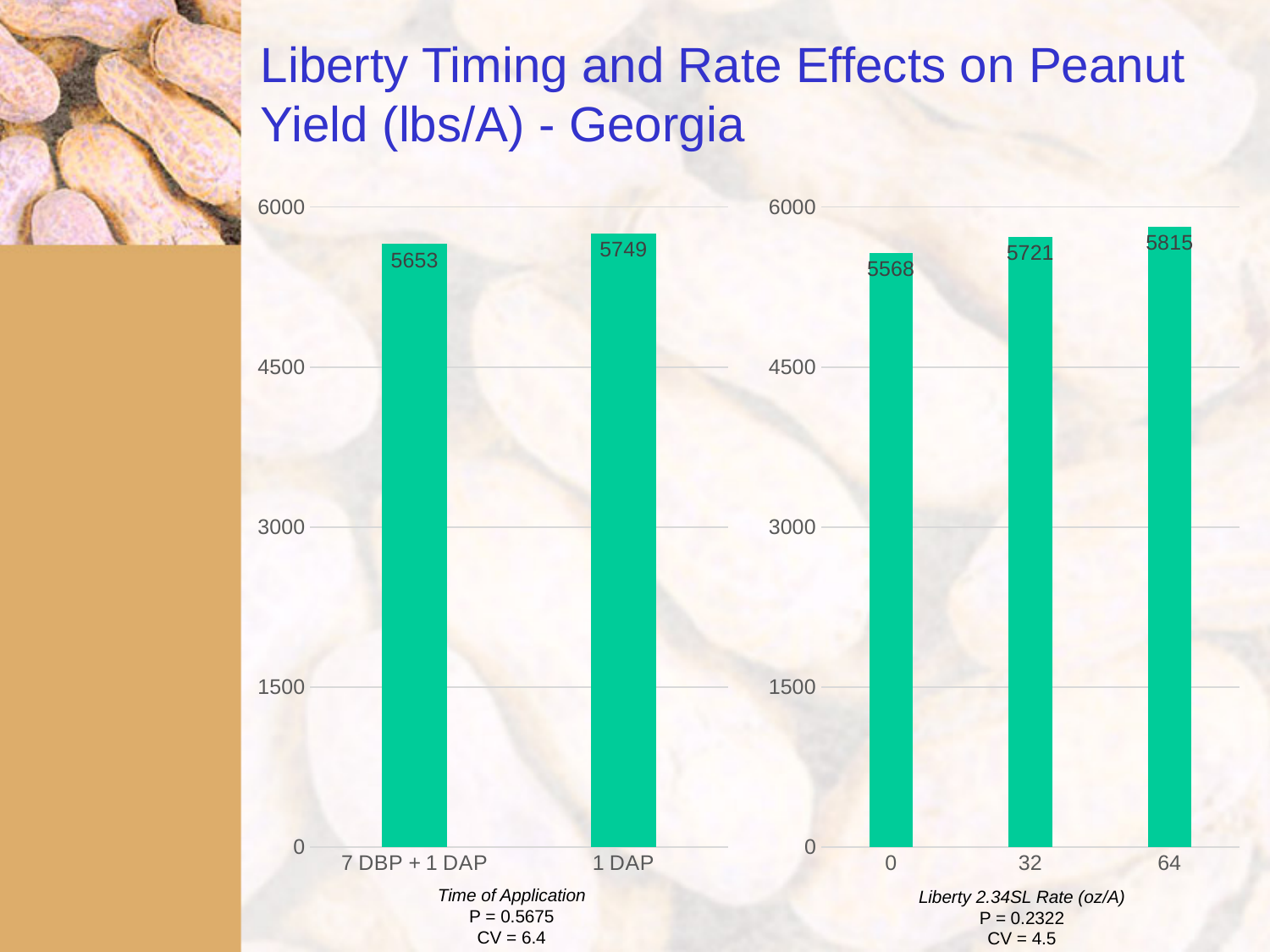
How many categories are shown in the right chart (Liberty 2.34SL Rate)? 3 In the right chart (Liberty 2.34SL Rate), do yields rise or fall as the rate increases from 0 to 64? Rise In the left chart (Time of Application), what is the yield for 7 DBP + 1 DAP? 5653 What type of chart is the left chart (Time of Application)? Bar chart In the right chart (Liberty 2.34SL Rate), what is the difference in yield between the 64 and 0 oz/A rates? 247 In the left chart (Time of Application), which has the larger yield, 7 DBP + 1 DAP or 1 DAP? 1 DAP In the right chart (Liberty 2.34SL Rate), which rate has the highest yield? 64 In the left chart (Time of Application), what is the difference in yield between 1 DAP and 7 DBP + 1 DAP? 96 In the right chart (Liberty 2.34SL Rate), what is the yield at the 0 oz/A rate? 5568 In the left chart (Time of Application), what is the yield for 1 DAP? 5749 In the right chart (Liberty 2.34SL Rate), which rate has the lowest yield? 0 In the right chart (Liberty 2.34SL Rate), what is the yield at the 32 oz/A rate? 5721